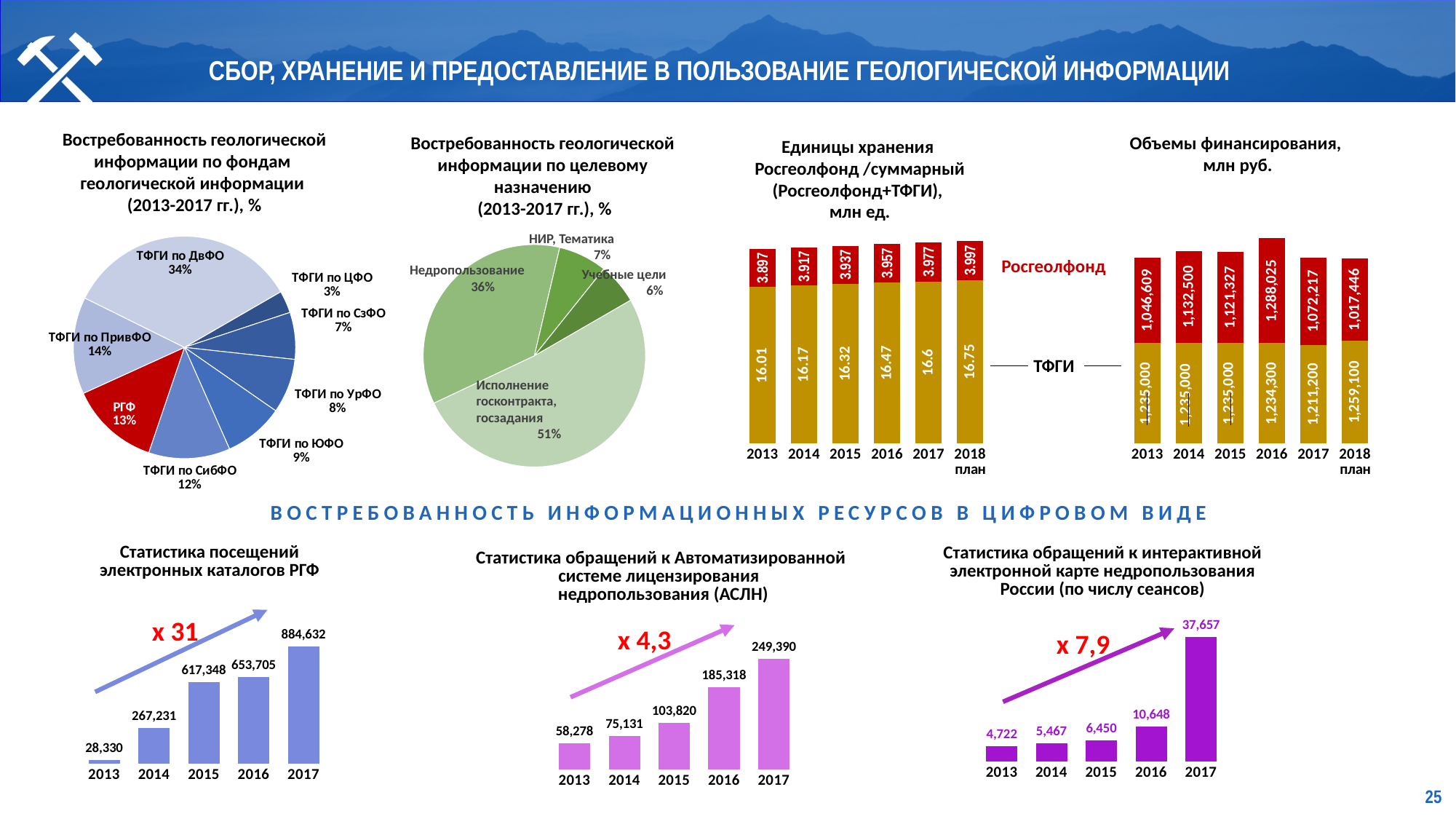
In the chart 'Статистика посещений электронных каталогов РГФ', what is the difference between the 2016 and 2015 values? 36,357 How many slices does the pie chart 'Востребованность геологической информации по целевому назначению (2013-2017 гг.), %' have? 4 In the chart 'Статистика посещений электронных каталогов РГФ', what is the value for 2017? 884,632 In the chart 'Единицы хранения Росгеолфонд /суммарный (Росгеолфонд+ТФГИ), млн ед.', what is the ТФГИ value for 2015? 16.32 In the chart 'Объемы финансирования, млн руб.', which year has the highest red (upper) segment? 2016 In the chart 'Единицы хранения Росгеолфонд /суммарный (Росгеолфонд+ТФГИ), млн ед.', do the Росгеолфонд values rise or fall from 2013 to 2018 план? rise In the chart 'Статистика обращений к Автоматизированной системе лицензирования недропользования (АСЛН)', what is the value for 2016? 185,318 In the pie chart 'Востребованность геологической информации по целевому назначению (2013-2017 гг.), %', what share does 'Исполнение госконтракта, госзадания' have? 51% In the pie chart 'Востребованность геологической информации по фондам геологической информации (2013-2017 гг.), %', which category has the smallest share? ТФГИ по ЦФО In the chart 'Статистика обращений к интерактивной электронной карте недропользования России (по числу сеансов)', which year has the highest value? 2017 In the pie chart 'Востребованность геологической информации по фондам геологической информации (2013-2017 гг.), %', what share does ТФГИ по ДвФО have? 34% In the chart 'Объемы финансирования, млн руб.', what is the value of the red (upper) segment for 2016? 1,288,025